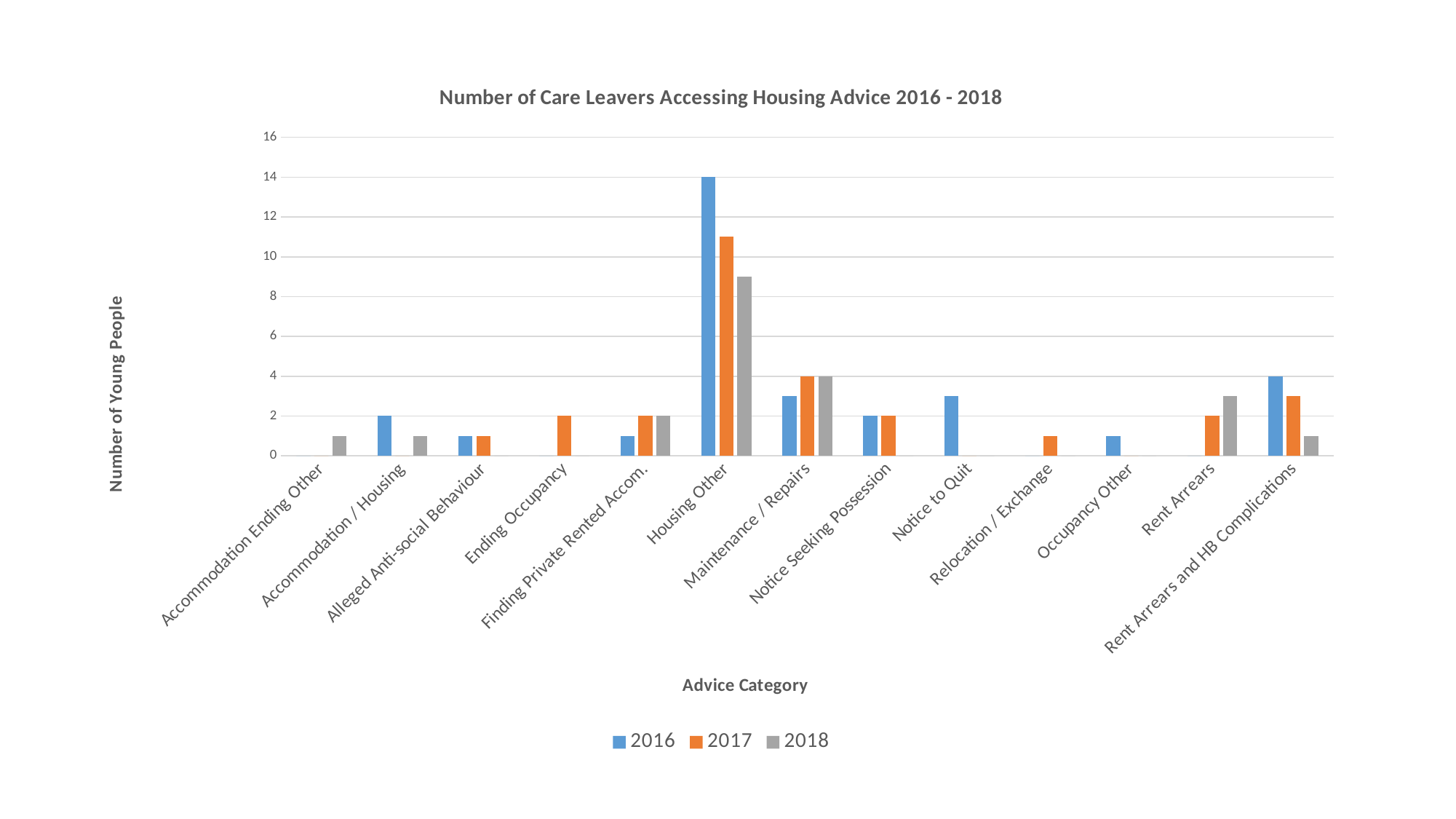
How many series does the legend list? 3 What is the value for Rent Arrears and HB Complications in 2016? 4 What is the difference between the 2016 value for Housing Other and the 2017 value for Maintenance / Repairs? 10 Which is larger for Housing Other: the 2016 value or the 2018 value? 2016 Which advice category has the highest number of young people in 2016? Housing Other How many advice categories are shown on the x axis? 13 What is the value for Notice Seeking Possession in 2017? 2 What type of chart is shown on the slide? Bar chart What is the value for Housing Other in 2016? 14 Is the value for Housing Other in 2017 greater or less than 10? greater What is the value for Maintenance / Repairs in 2017? 4 Is the value for Housing Other in 2018 greater or less than 10? less